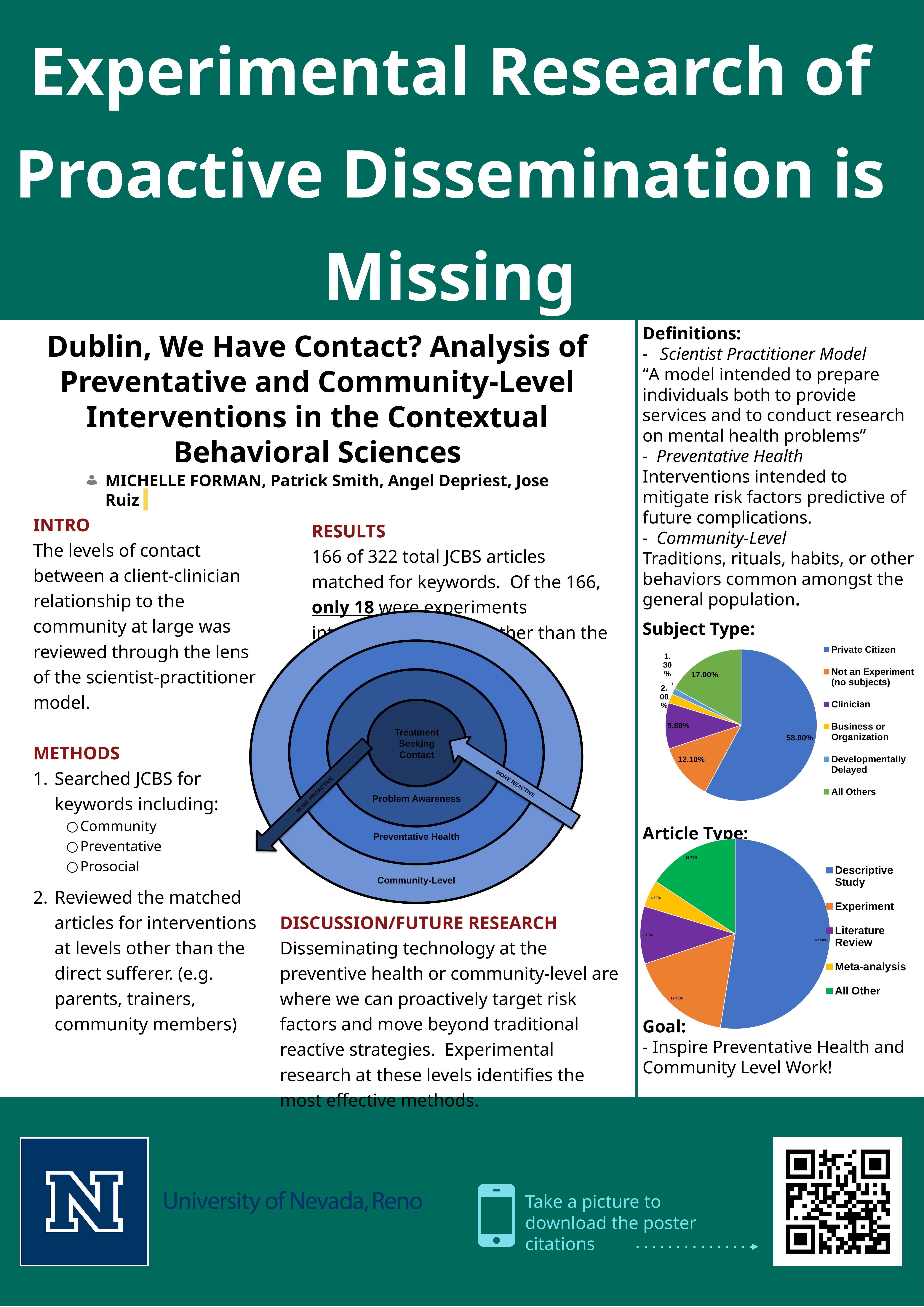
In the Article Type chart, what percentage is shown for Descriptive Study? 52.50% In the Article Type chart, which is larger, Literature Review or All Other? All Other In the Subject Type chart, which category has the largest slice? Private Citizen In the Subject Type chart, how many categories does the legend list? 6 In the Article Type chart, which category has the smallest slice? Meta-analysis In the Subject Type chart, what percentage is shown for Private Citizen? 58.00% In the Subject Type chart, what percentage is shown for Clinician? 9.80% What type of chart is the Article Type chart? Pie chart In the Subject Type chart, what percentage is shown for All Others? 17.00% In the Subject Type chart, which category has the smallest slice? Developmentally Delayed In the Subject Type chart, what is the difference between the Private Citizen and Not an Experiment (no subjects) percentages? 45.90% In the Article Type chart, what percentage is shown for Experiment? 17.40%